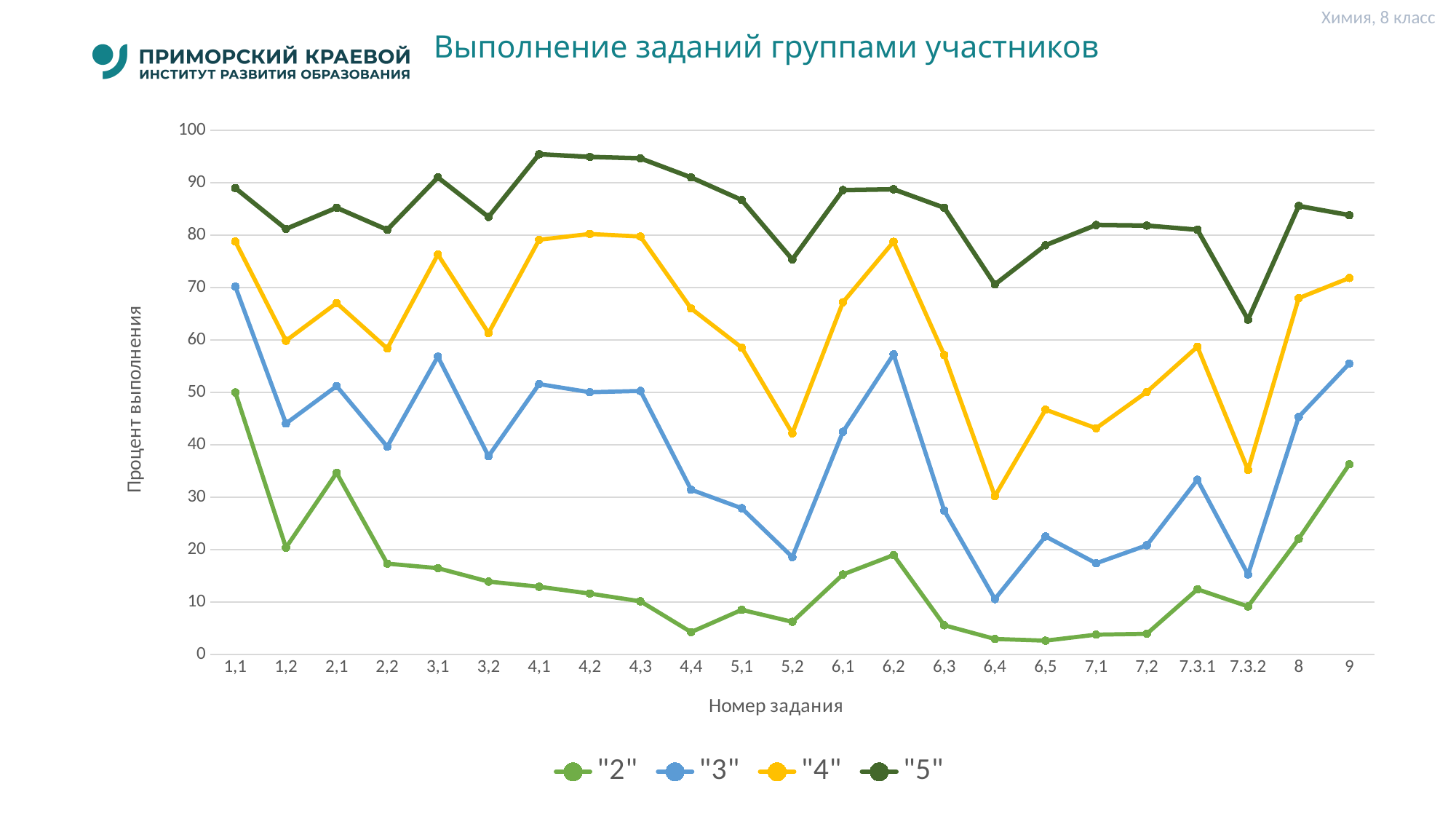
How many series does the legend list? 4 Does the value of series "5" rise or fall from task 7.3.1 to task 7.3.2? fall What kind of chart is shown on the slide? line chart At task 6,2, which series has the larger value, "3" or "4"? "4" For which task number is the value of series "3" lowest? 6,4 How many task numbers are plotted along the x axis? 23 Is the value for series "3" at task 4,4 greater or less than 40? less For which task number is the value of series "4" lowest? 6,4 Is the value for series "5" at task 5,2 greater or less than 80? less Is the value for series "4" at task 6,2 greater or less than 70? greater For which task number is the value of series "5" lowest? 7.3.2 For which task number is the value of series "2" highest? 1,1